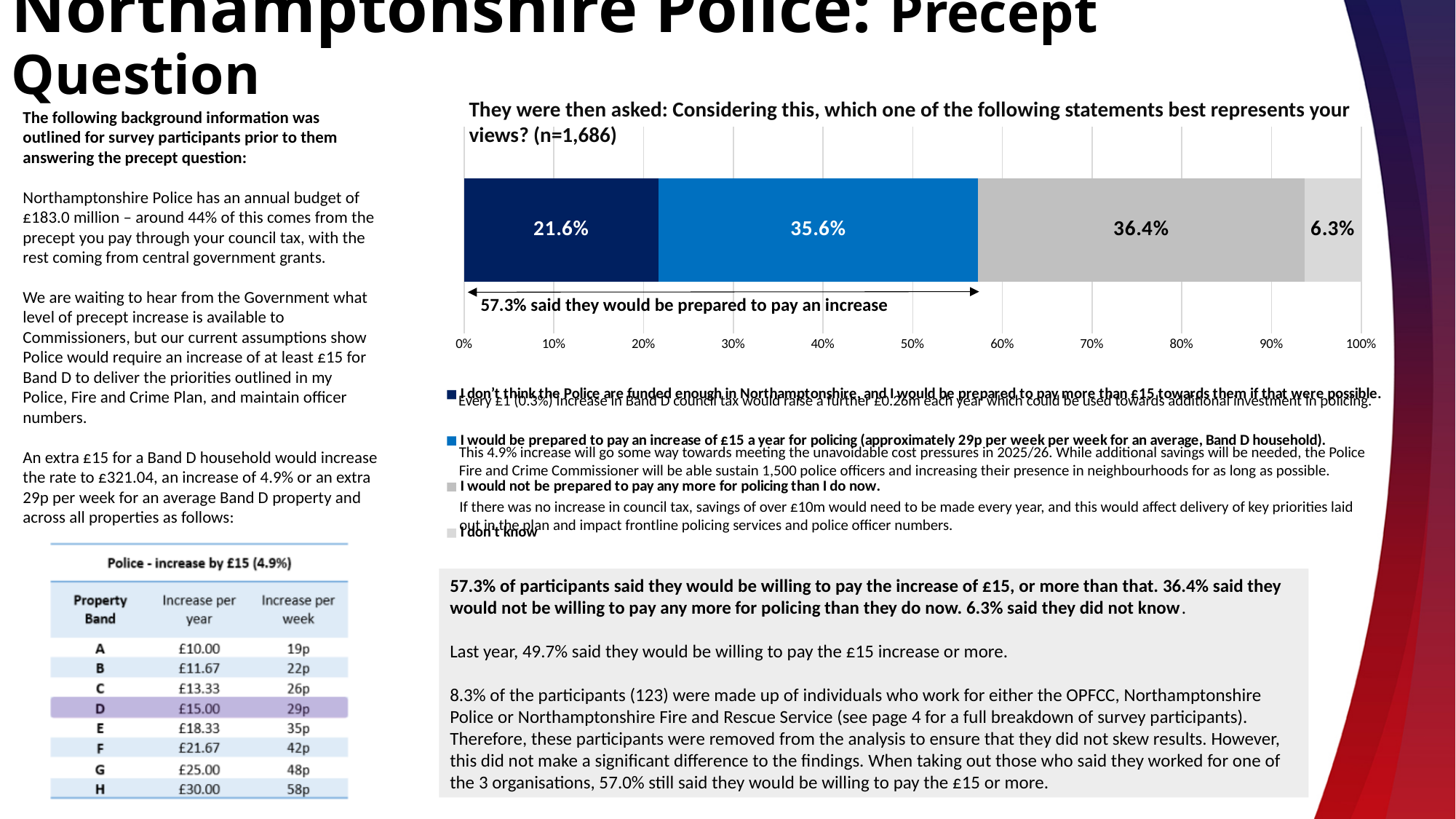
How many entries does the legend list? 4 What percentage of respondents answered 'I don't know'? 6.3% Which response option has the smallest share in the bar? I don't know Is the share of respondents who would pay more than £15 larger or smaller than the share who would not pay any more? Smaller What percentage of respondents said they would not be prepared to pay any more for policing than they do now? 36.4% What percentage of respondents said they would be prepared to pay more than £15 towards the Police? 21.6% What kind of chart is shown on the slide? Stacked bar chart What percentage of respondents said they would be prepared to pay an increase of £15 a year for policing? 35.6% What is the combined share of respondents who would be prepared to pay more than £15 (21.6%) and those who would pay £15 a year (35.6%)? 57.2% How many segments make up the stacked bar? 4 What is the sample size (n) stated in the chart title? 1,686 What is the difference between the share who would pay £15 a year (35.6%) and the share who would pay more than £15 (21.6%)? 14.0%